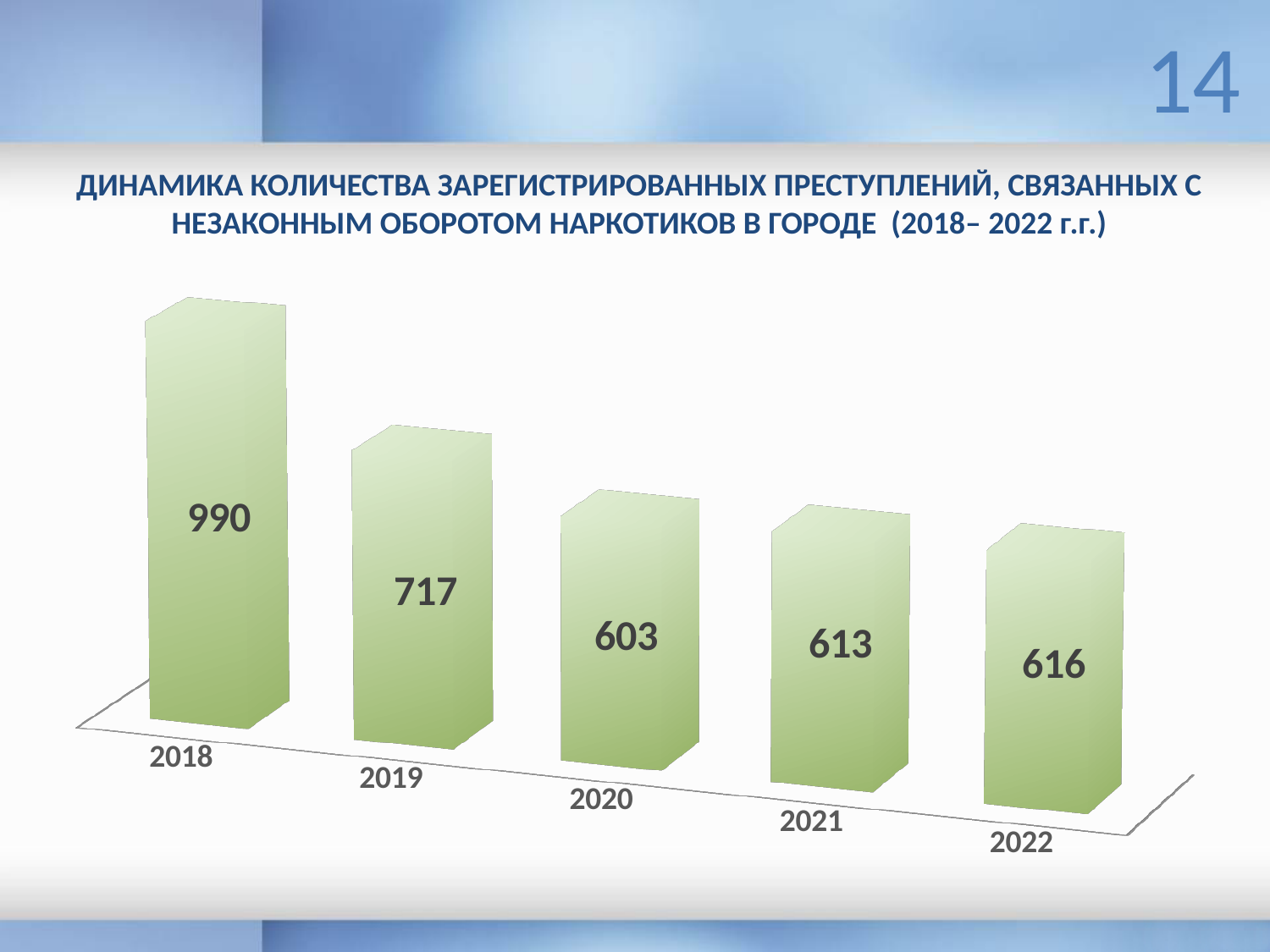
Which is larger, the value for 2019 or the value for 2021? 2019 What is the value for 2018? 990 Which year has the lowest value? 2020 What kind of chart is shown on the slide? bar chart What is the value for 2020? 603 How many years are shown on the chart? 5 Which year has the highest value? 2018 What period of years does the chart title cover? 2018–2022 Do the values rise or fall from 2018 to 2020? fall What is the difference between the values for 2018 and 2019? 273 What is the difference between the values for 2022 and 2021? 3 What is the value for 2022? 616